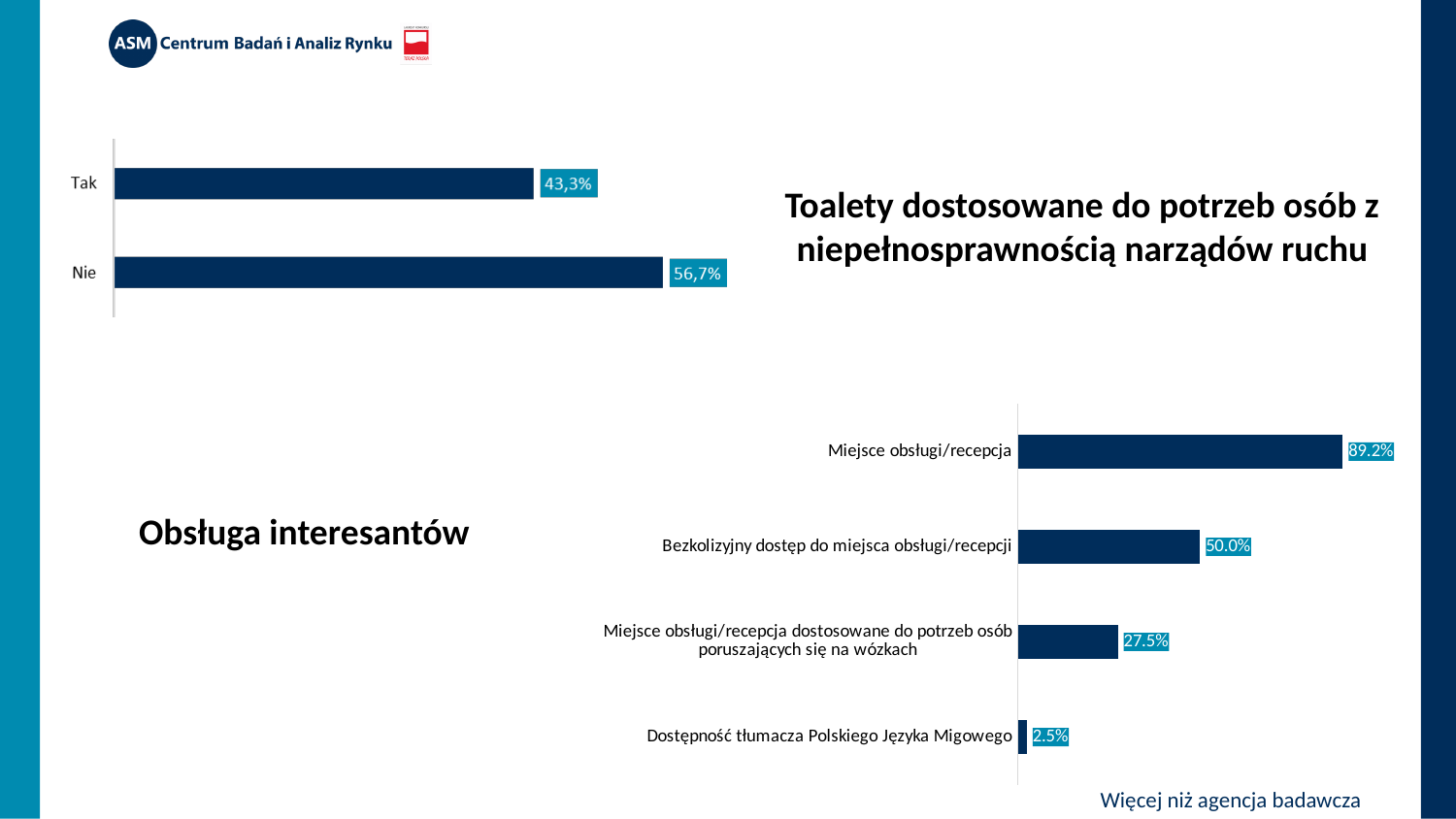
In the 'Obsługa interesantów' chart, what is the difference between 'Miejsce obsługi/recepcja' and 'Miejsce obsługi/recepcja dostosowane do potrzeb osób poruszających się na wózkach'? 61.7% In the 'Toalety dostosowane do potrzeb osób z niepełnosprawnością narządów ruchu' chart, what is the value for 'Tak'? 43,3% In the 'Toalety dostosowane do potrzeb osób z niepełnosprawnością narządów ruchu' chart, what is the value for 'Nie'? 56,7% In the 'Toalety dostosowane do potrzeb osób z niepełnosprawnością narządów ruchu' chart, which category has the higher value? Nie In the 'Obsługa interesantów' chart, how many categories are shown? 4 In the 'Toalety dostosowane do potrzeb osób z niepełnosprawnością narządów ruchu' chart, how many categories are shown? 2 In the 'Obsługa interesantów' chart, what is the value for 'Bezkolizyjny dostęp do miejsca obsługi/recepcji'? 50.0% In the 'Obsługa interesantów' chart, what is the value for 'Dostępność tłumacza Polskiego Języka Migowego'? 2.5% What type of chart is the 'Obsługa interesantów' chart? Bar chart In the 'Toalety dostosowane do potrzeb osób z niepełnosprawnością narządów ruchu' chart, what is the difference between 'Nie' and 'Tak'? 13,4% In the 'Obsługa interesantów' chart, what is the value for 'Miejsce obsługi/recepcja'? 89.2% In the 'Obsługa interesantów' chart, which category has the lowest value? Dostępność tłumacza Polskiego Języka Migowego